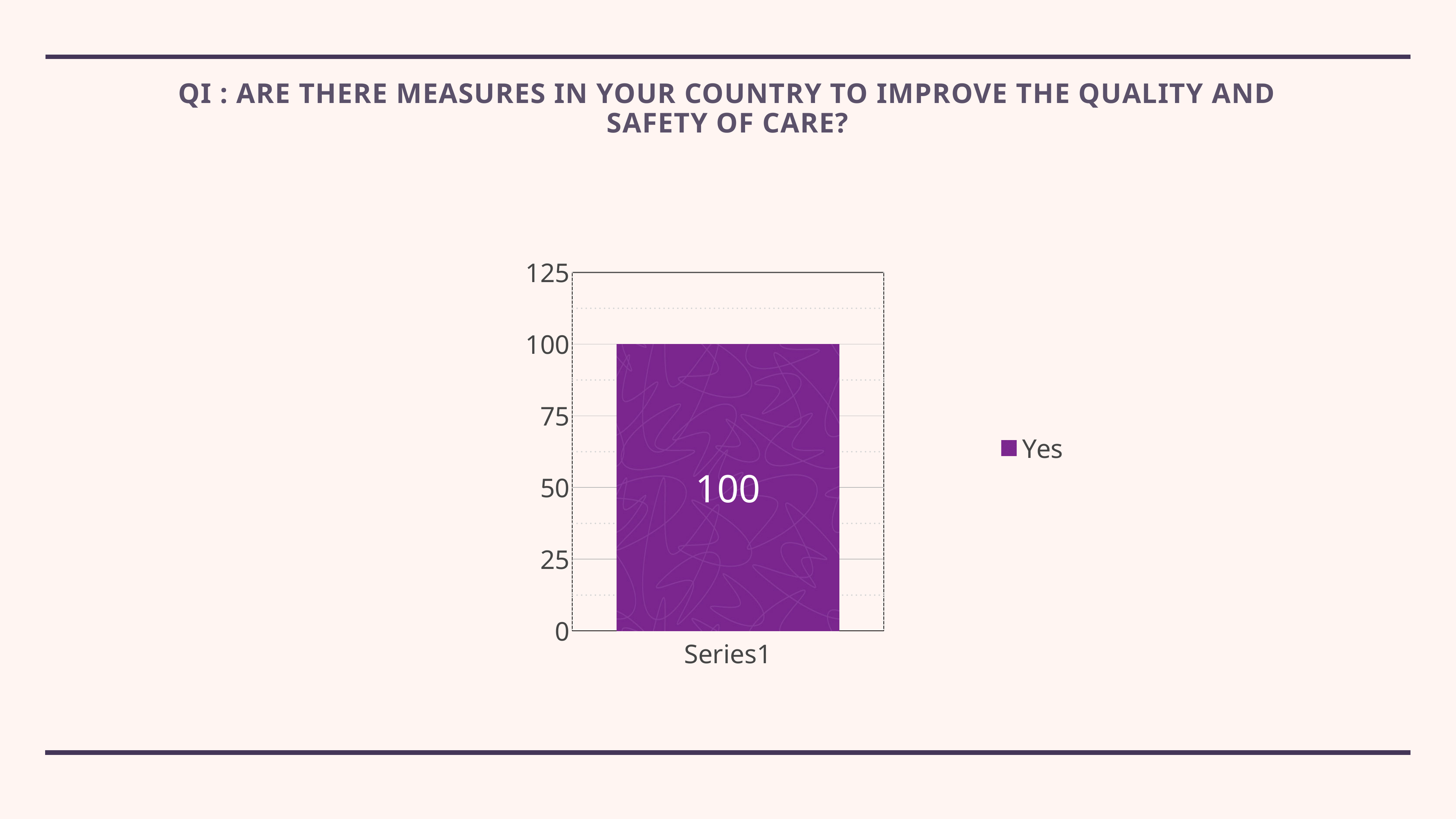
What is the label of the category on the x axis? Series1 Is the value for Series1 greater or less than 75? greater How many series does the legend list? 1 How many bars are plotted in the chart? 1 What kind of chart is shown on the slide? bar chart What series name appears in the legend? Yes What is the value shown for the Yes series? 100 What is the value of the bar for Series1? 100 Is the value for Series1 greater or less than 125? less What is the highest value shown on the vertical axis? 125